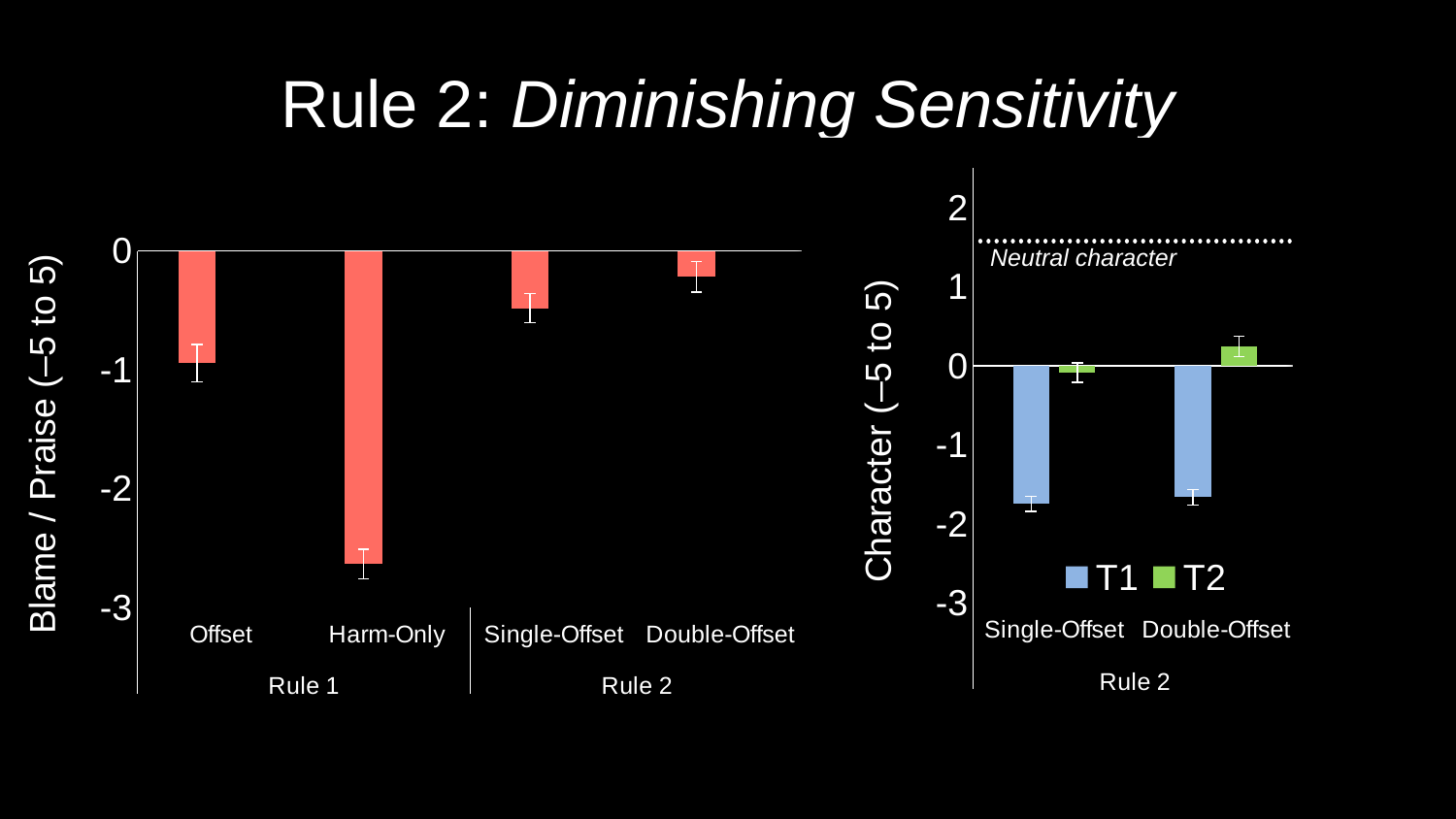
In the left chart (Blame / Praise), which category has the lowest value? Harm-Only In the right chart (Character), what are the two legend entries? T1 and T2 In the left chart (Blame / Praise), is the value for Single-Offset greater or less than -1? greater In the left chart (Blame / Praise), which category has the highest value? Double-Offset In the left chart (Blame / Praise), is the value for Offset greater or less than -2? greater In the right chart (Character), which series has the larger value for Double-Offset, T1 or T2? T2 In the left chart (Blame / Praise), how many categories are shown on the x axis? 4 In the left chart (Blame / Praise), is the value for Harm-Only greater or less than -2? less What kind of chart is the left chart (Blame / Praise)? bar chart In the left chart (Blame / Praise), which has the larger value, Offset or Harm-Only? Offset In the right chart (Character), how many series does the legend list? 2